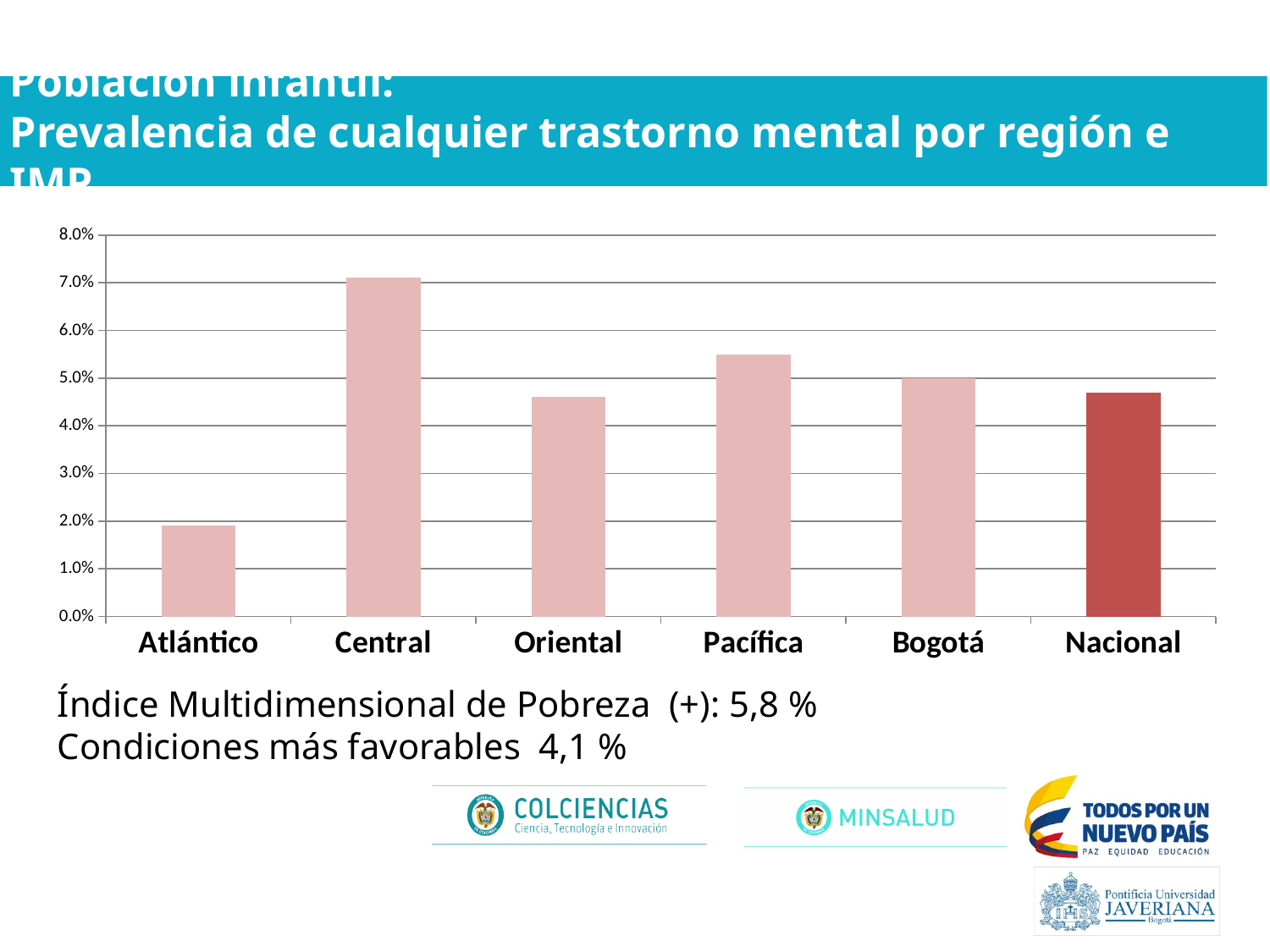
Is the value for Oriental greater or less than 5.0%? less Which has a larger value, Central or Pacífica? Central Which bar in the chart is shown in a darker red colour than the others? Nacional Which has a larger value, Atlántico or Oriental? Oriental Which category has the highest value in the chart? Central Is the value for Central greater or less than 6.0%? greater Which category has the lowest value in the chart? Atlántico How many categories are shown on the x axis of the chart? 6 What kind of chart is shown on the slide? bar chart Is the value for Nacional greater or less than 4.0%? greater